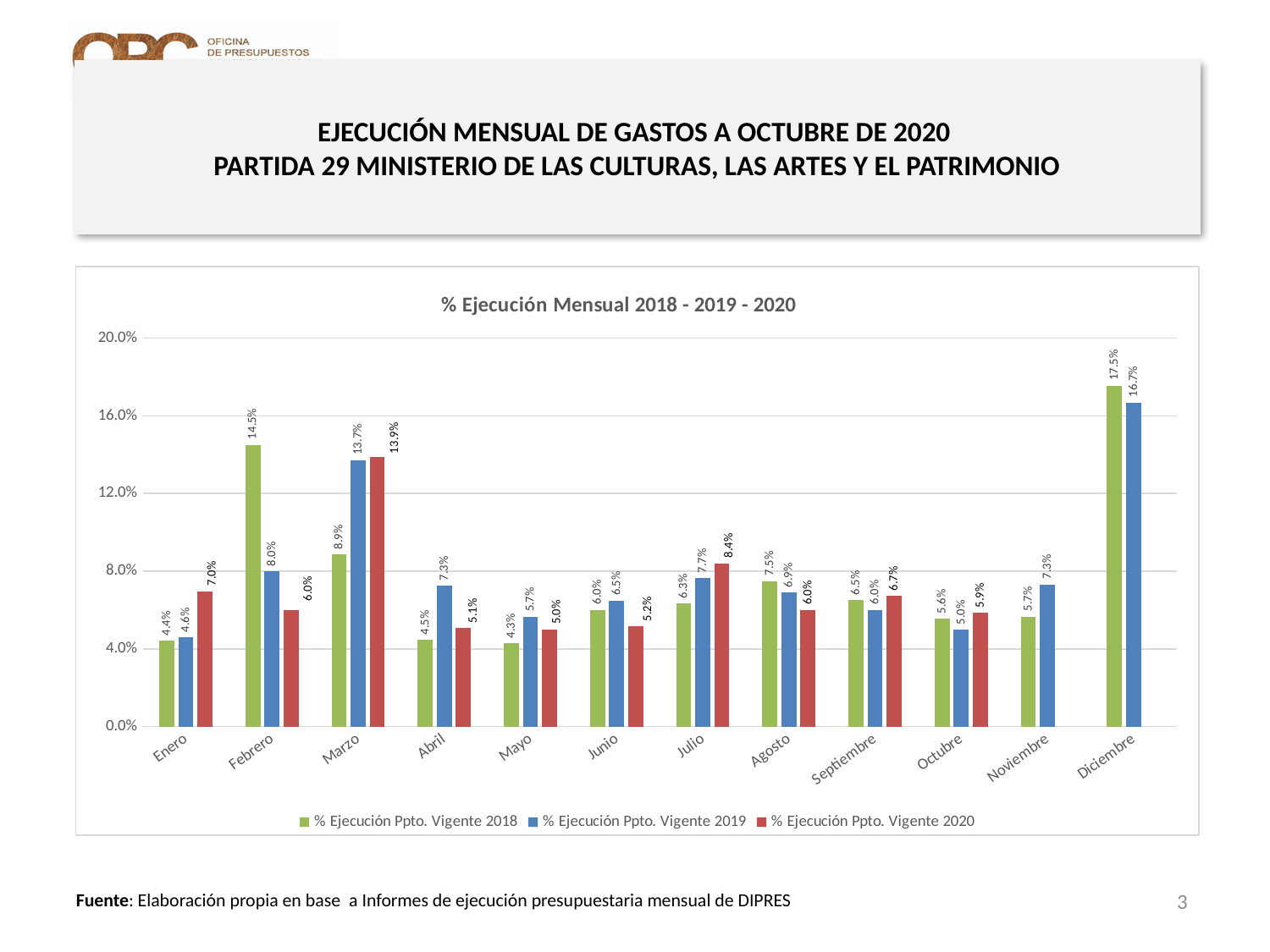
Which month has the highest value in the % Ejecución Ppto. Vigente 2018 series? Diciembre What is the value for Marzo in the % Ejecución Ppto. Vigente 2020 series? 13.9% What is the title of the chart? % Ejecución Mensual 2018 - 2019 - 2020 What is the value for Febrero in the % Ejecución Ppto. Vigente 2018 series? 14.5% What is the value for Noviembre in the % Ejecución Ppto. Vigente 2019 series? 7.3% What kind of chart is shown? Bar chart Which is larger for Julio: the 2019 value or the 2020 value? 2020 value (8.4%) How many months are shown on the x axis? 12 What is the difference between the 2018 and 2019 values for Diciembre? 0.8% Which month has the lowest value in the % Ejecución Ppto. Vigente 2020 series? Mayo Is the value for Febrero in the 2018 series greater or less than 12.0%? greater How many series does the legend list? 3